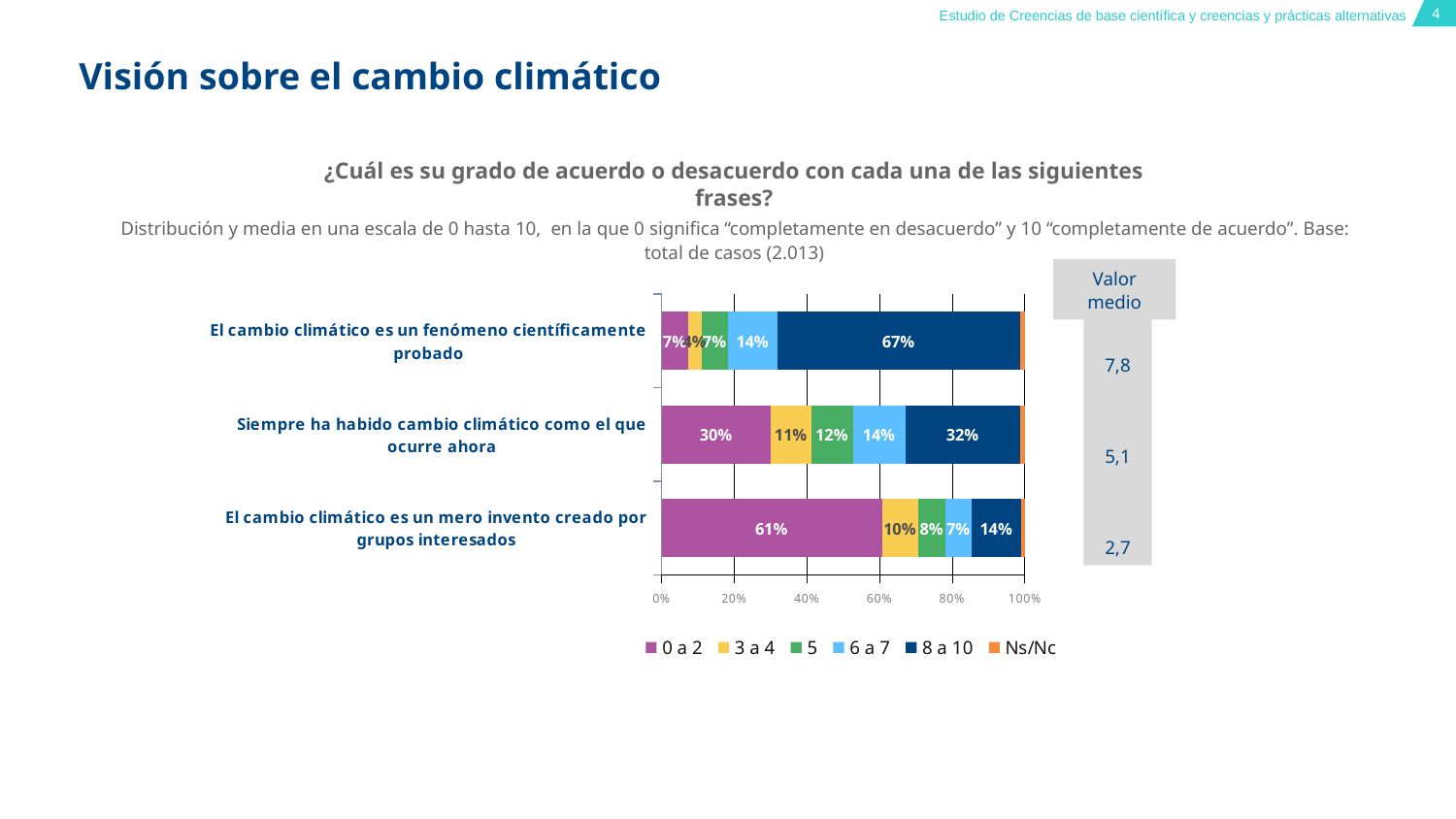
How many series does the legend list? 6 Which is larger for "Siempre ha habido cambio climático como el que ocurre ahora": the 0 a 2 share or the 8 a 10 share? 8 a 10 What is the difference between the 0 a 2 share for "Siempre ha habido cambio climático como el que ocurre ahora" and the 0 a 2 share for "El cambio climático es un fenómeno científicamente probado"? 23% What is the mean value (Valor medio) for "Siempre ha habido cambio climático como el que ocurre ahora"? 5,1 What percentage of respondents gave a score of 8 a 10 for "El cambio climático es un fenómeno científicamente probado"? 67% What percentage gave a score of 5 for "Siempre ha habido cambio climático como el que ocurre ahora"? 12% Which statement has the lowest share of respondents scoring 8 a 10? El cambio climático es un mero invento creado por grupos interesados Which legend entry is shown in orange? Ns/Nc What type of chart is shown on the slide? stacked bar chart Which statement has the highest mean value (Valor medio)? El cambio climático es un fenómeno científicamente probado How many statements (categories) are plotted in the chart? 3 What percentage gave a score of 0 a 2 for "El cambio climático es un mero invento creado por grupos interesados"? 61%